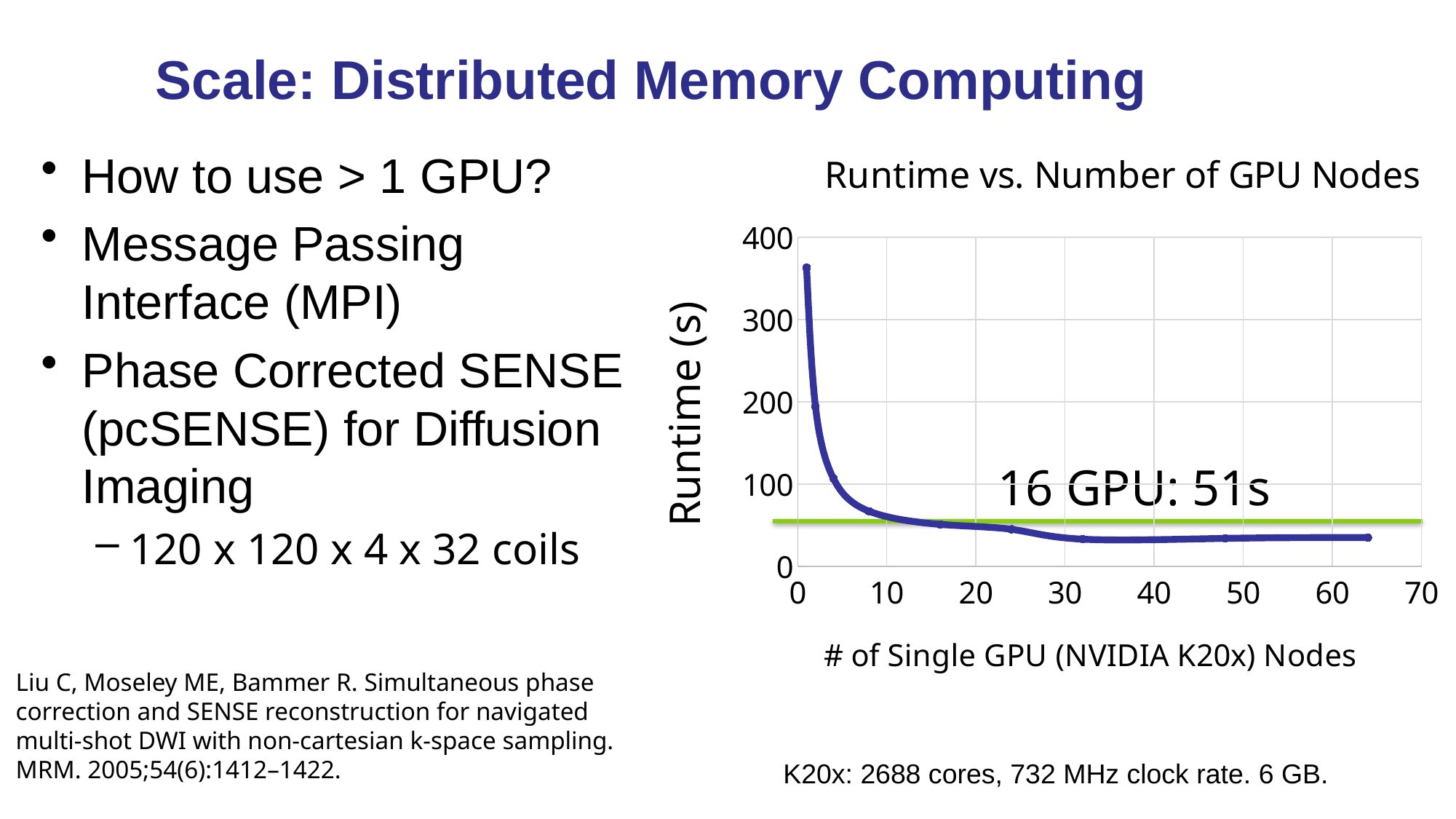
What kind of chart is shown on the slide? line chart At which number of GPU nodes is the runtime highest? 1 Is the runtime for 1 GPU node greater or less than 300 seconds? greater What is the title of the chart? Runtime vs. Number of GPU Nodes Which has the larger runtime: 4 GPU nodes or 32 GPU nodes? 4 GPU nodes What is the label of the y axis of the chart? Runtime (s) Does the runtime rise or fall as the number of GPU nodes increases from 1 to 16? fall Which has the larger runtime: 1 GPU node or 64 GPU nodes? 1 GPU node What is the highest value shown on the y axis of the chart? 400 Is the runtime for 2 GPU nodes greater or less than 100 seconds? greater According to the annotation on the chart, what is the runtime with 16 GPUs? 51s Is the runtime for 64 GPU nodes greater or less than 100 seconds? less